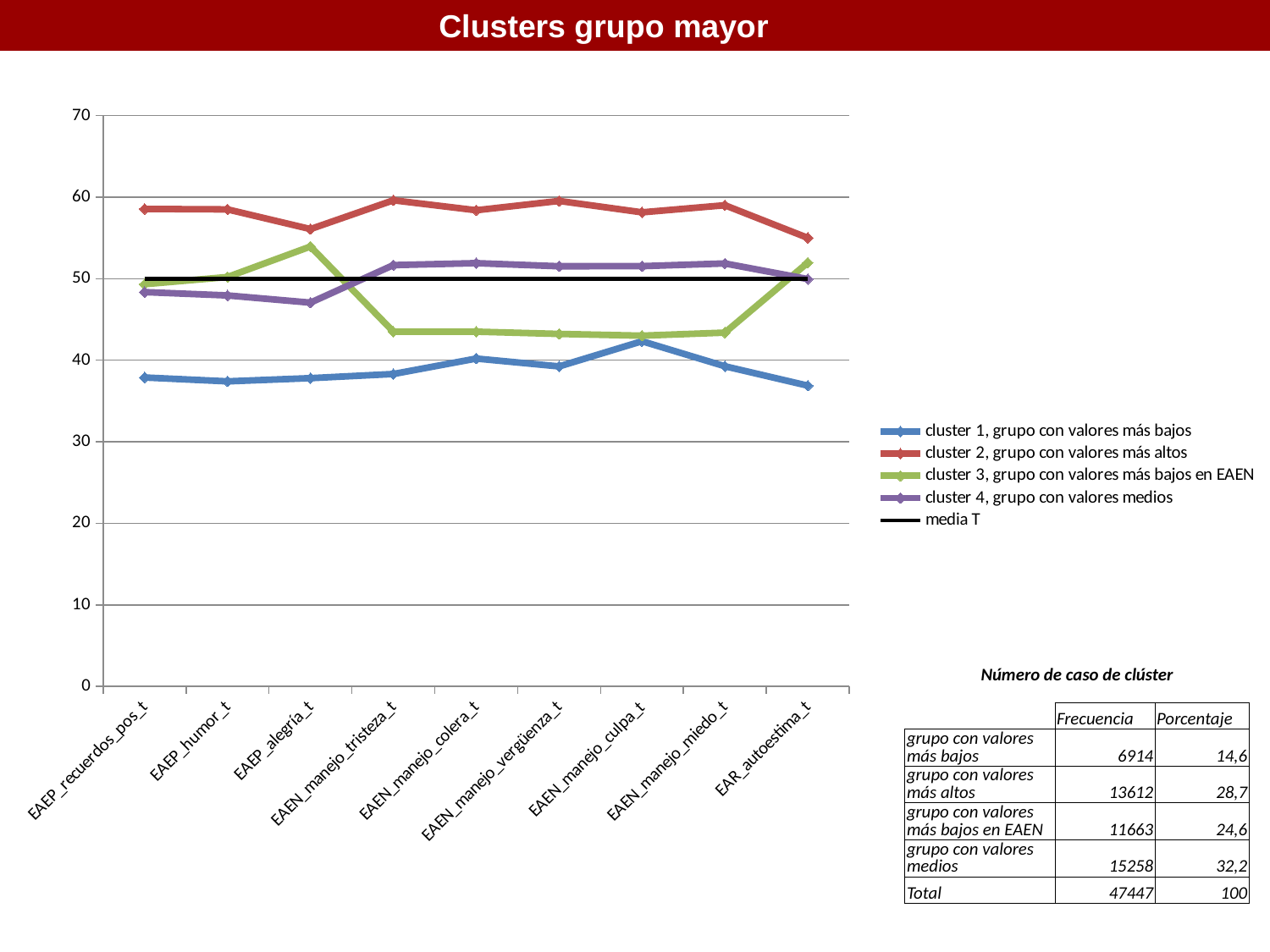
For the series 'cluster 3, grupo con valores más bajos en EAEN', which category has the highest value? EAEP_alegría_t How many categories are plotted along the x axis of the chart? 9 What is the title of the slide containing the chart? Clusters grupo mayor Which series has the highest value at EAEP_recuerdos_pos_t? cluster 2, grupo con valores más altos Which series has the lowest value at EAEN_manejo_tristeza_t? cluster 1, grupo con valores más bajos Is the value for 'cluster 2, grupo con valores más altos' at EAEN_manejo_tristeza_t greater or less than 50? greater Is the value for 'cluster 1, grupo con valores más bajos' at EAR_autoestima_t greater or less than 40? less How many series does the chart legend list? 5 Is the value for 'cluster 3, grupo con valores más bajos en EAEN' at EAEN_manejo_colera_t greater or less than 50? less Does the value for 'cluster 2, grupo con valores más altos' rise or fall from EAEN_manejo_miedo_t to EAR_autoestima_t? fall What kind of chart is shown on the slide? line chart At EAEN_manejo_culpa_t, which is larger: the value for 'cluster 4, grupo con valores medios' or for 'cluster 3, grupo con valores más bajos en EAEN'? cluster 4, grupo con valores medios